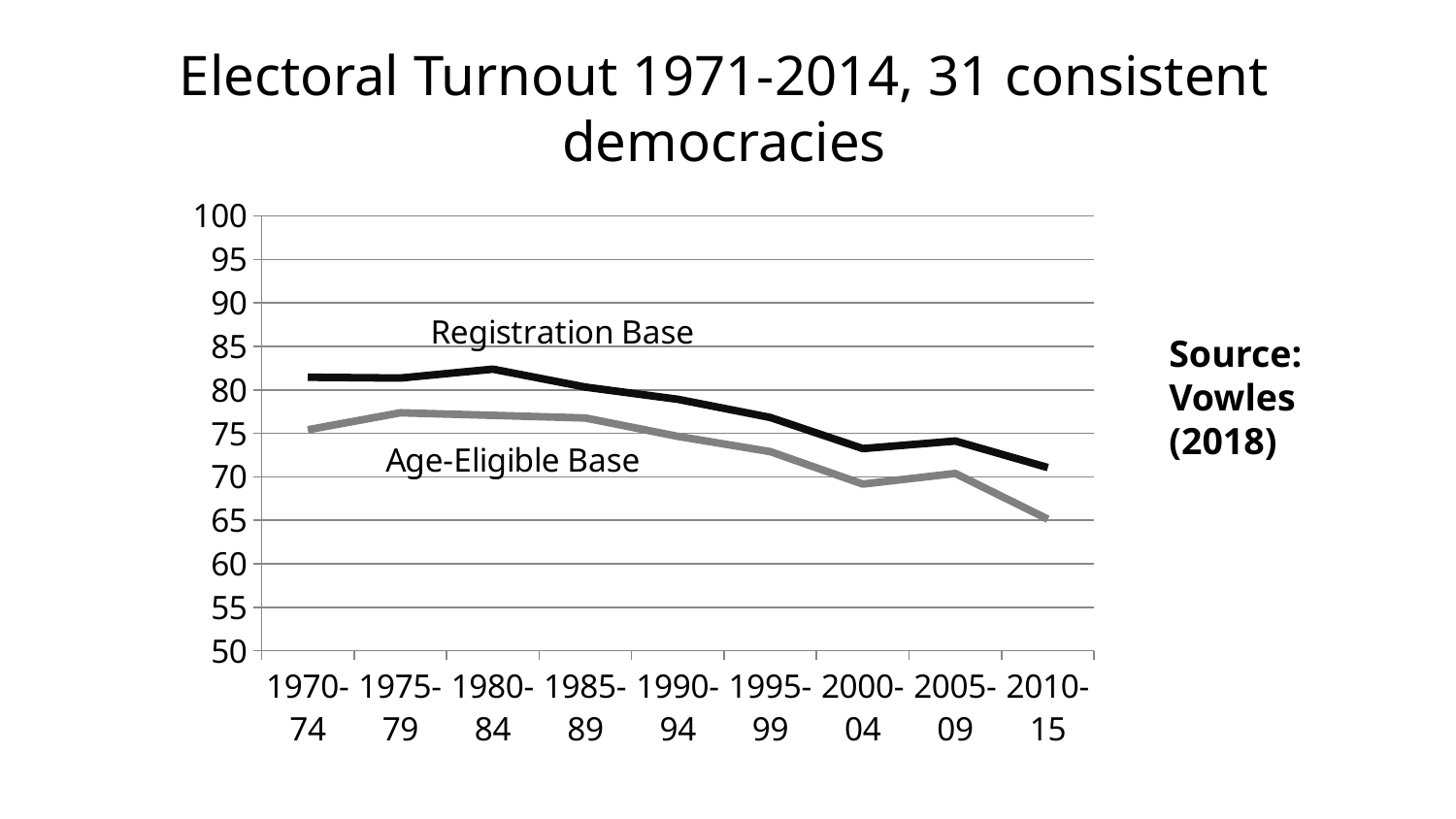
Is the Age-Eligible Base value for 1975-79 greater or less than 75? greater How many data series are plotted on the chart? 2 Which series has the higher value in 2010-15, Registration Base or Age-Eligible Base? Registration Base In which period is the Registration Base turnout lowest? 2010-15 What is the source cited for the chart? Vowles (2018) What kind of chart is shown on the slide? line chart Which series is plotted with the black line? Registration Base Overall, does the Registration Base turnout rise or fall from 1970-74 to 2010-15? fall In which period is the Age-Eligible Base turnout lowest? 2010-15 Is the Age-Eligible Base value for 2010-15 greater or less than 70? less Is the Registration Base value for 1980-84 greater or less than 80? greater How many time periods are shown on the x axis? 9